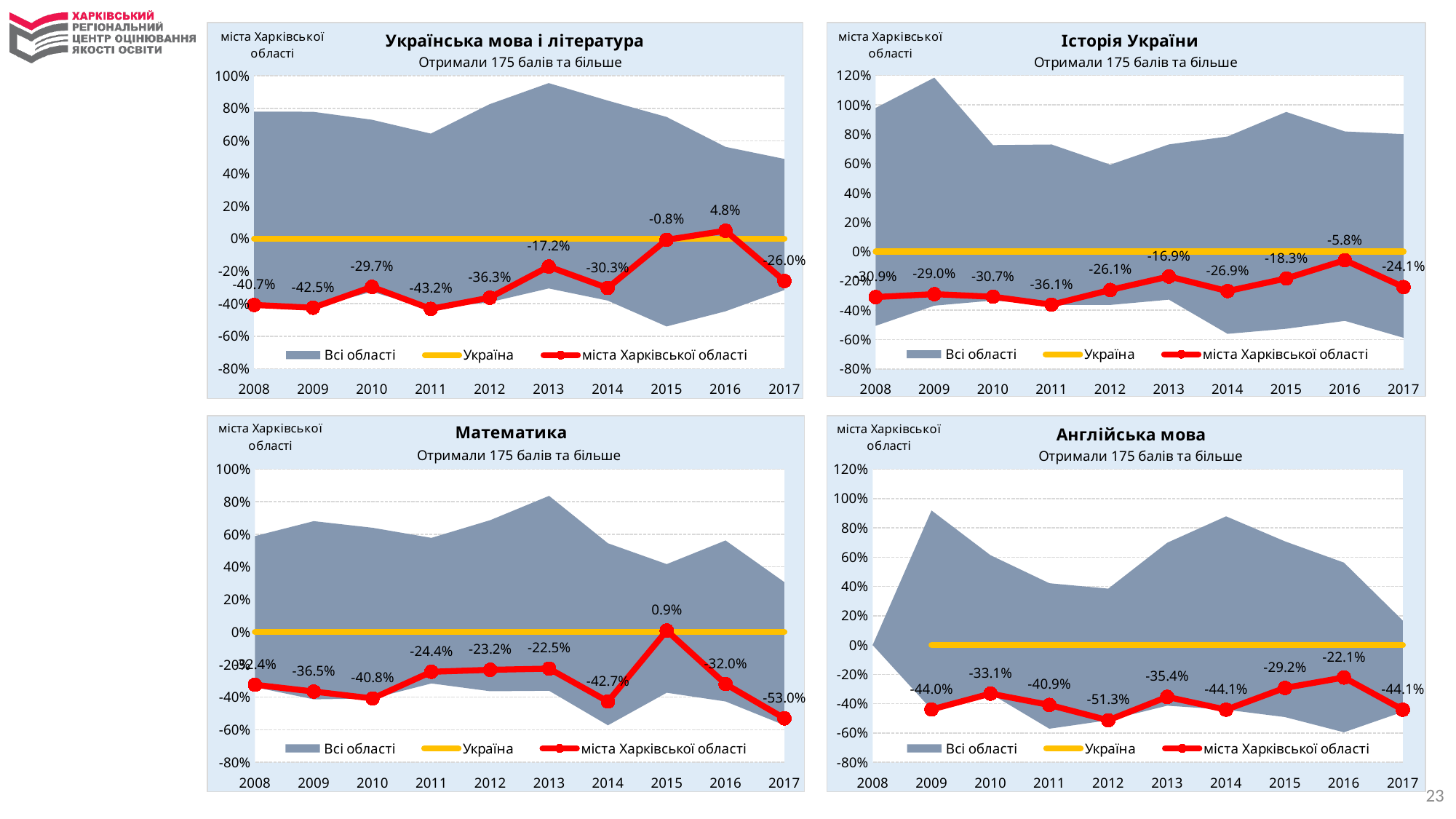
In the "Математика" chart, which year has the lowest value for міста Харківської області? 2017 How many series does the legend of the "Математика" chart list? 3 In the "Історія України" chart, what is the value for міста Харківської області in 2016? -5.8% In the "Англійська мова" chart, is the міста Харківської області value for 2015 larger or smaller than the value for 2014? larger In the "Математика" chart, what is the value for міста Харківської області in 2015? 0.9% How many years are shown on the x axis of the "Історія України" chart? 10 In the "Англійська мова" chart, which year has the highest value for міста Харківської області? 2016 In the "Історія України" chart, which year has the lowest value for міста Харківської області? 2011 In the "Математика" chart, what is the difference between the міста Харківської області values for 2016 and 2017? 21.0% In the "Англійська мова" chart, what is the value for міста Харківської області in 2012? -51.3% In the "Українська мова і література" chart, what is the value for міста Харківської області in 2016? 4.8% In the "Українська мова і література" chart, which year has the lowest value for міста Харківської області? 2011